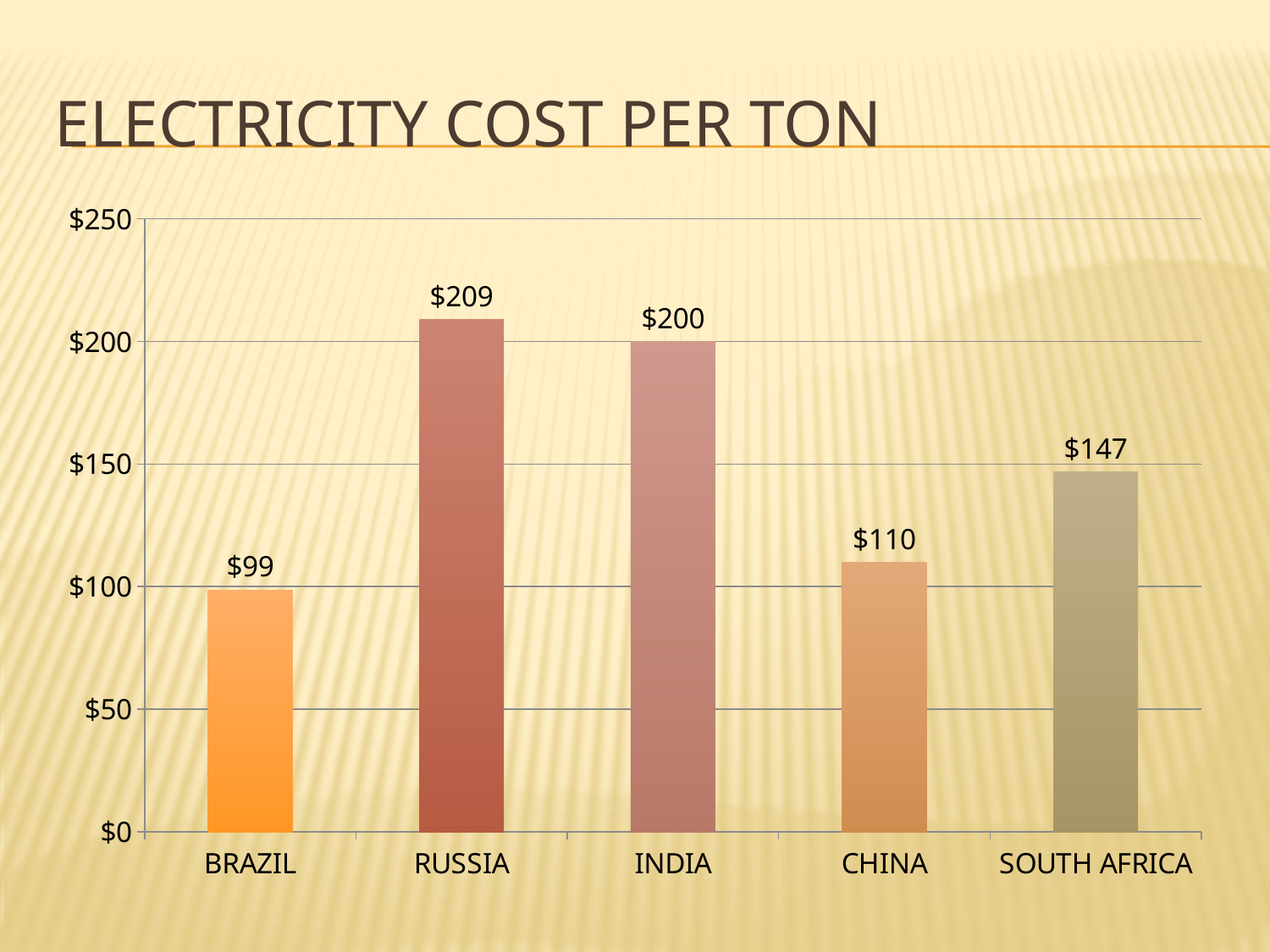
What is the title of the chart? Electricity Cost Per Ton What is the electricity cost per ton for Russia? $209 What is the electricity cost per ton for Brazil? $99 Is the value for India greater or less than $150? greater Which country has the highest electricity cost per ton? Russia What is the difference between the electricity cost per ton for Russia and India? $9 What kind of chart is shown on the slide? Bar chart What is the electricity cost per ton for South Africa? $147 Which country has the lowest electricity cost per ton? Brazil How many countries are shown in the chart? 5 Which has a higher electricity cost per ton, China or South Africa? South Africa What is the difference between the electricity cost per ton for South Africa and China? $37